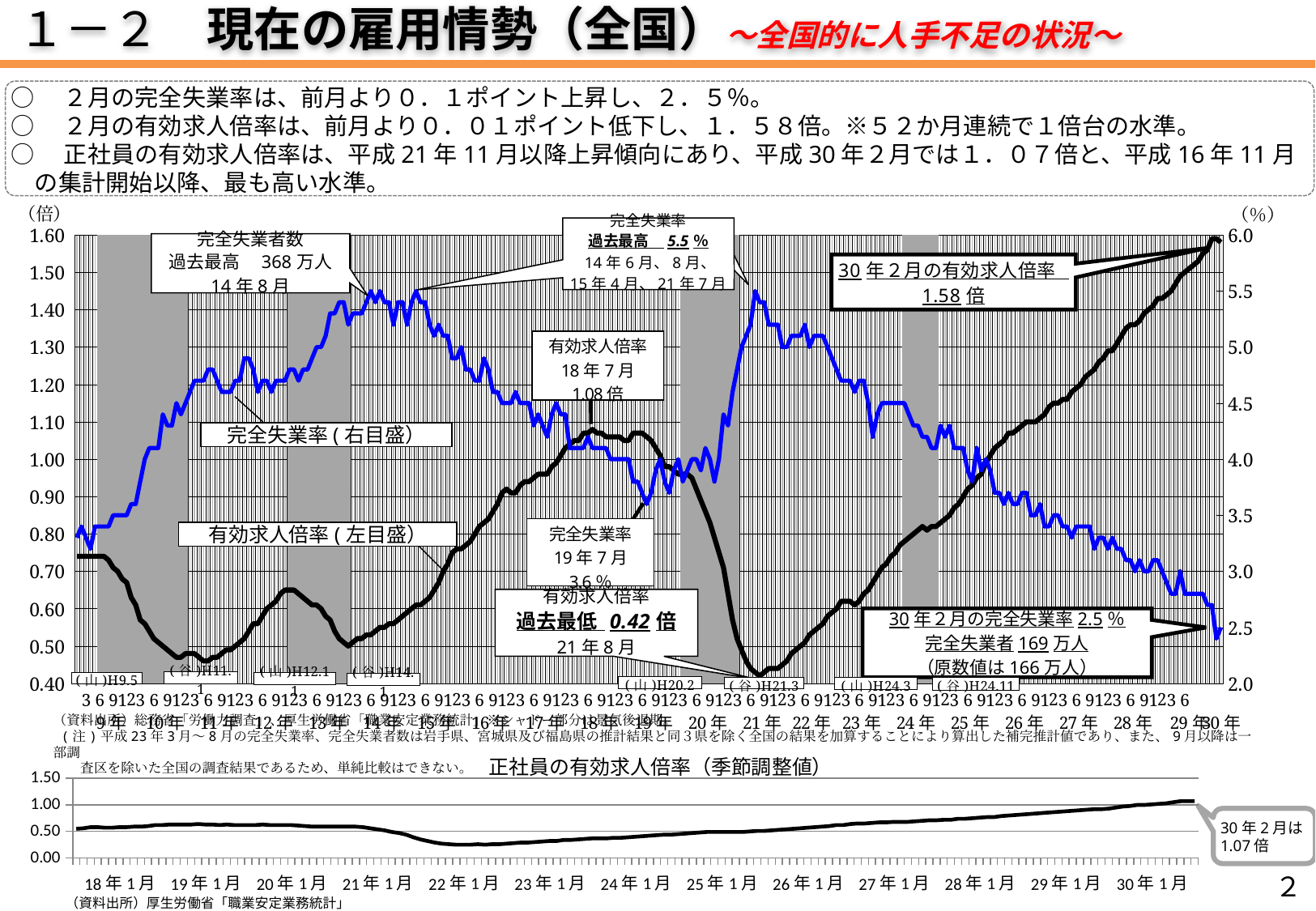
In the top chart, what is the 過去最高 (record high) value of the 完全失業率 shown in the callout? 5.5% In the top chart, what is the 過去最低 (record low) value of the 有効求人倍率 shown in the callout? 0.42倍 In the top chart, what is the 完全失業率 for 30年2月 according to the callout? 2.5% What type of chart is the bottom chart 正社員の有効求人倍率（季節調整値）? Line chart In the bottom chart 正社員の有効求人倍率（季節調整値）, what value is labelled for 30年2月? 1.07倍 In the top chart, how much higher is the 30年2月 有効求人倍率 (1.58倍) than the record low of 0.42倍? 1.16倍 In the bottom chart, is the value at 18年1月 greater or less than 1.00? less In the top chart, what is the difference between the record-high 完全失業率 of 5.5% and the 30年2月 value of 2.5%? 3.0 percentage points In the top chart, what unit is shown on the left axis and what unit on the right axis? Left: 倍; right: % In the top chart, what value of the 完全失業率 is labelled for 19年7月? 3.6% In the top chart, what is the 有効求人倍率 for 30年2月 according to the callout? 1.58倍 In the top chart, what value of the 有効求人倍率 is labelled for 18年7月? 1.08倍